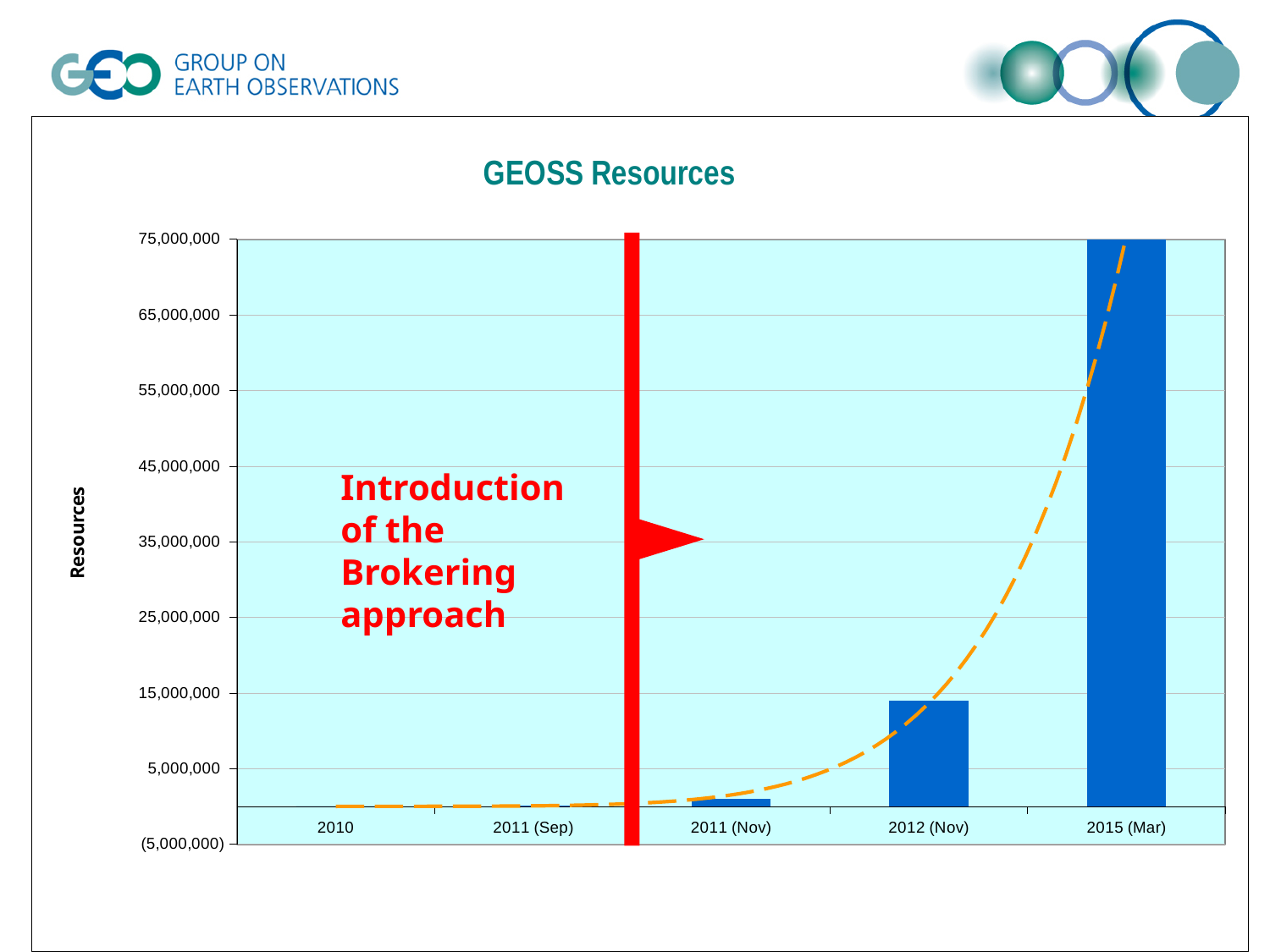
How many categories are shown on the x axis of the chart? 5 Which is larger, the value for 2011 (Nov) or the value for 2012 (Nov)? 2012 (Nov) Is the value for 2012 (Nov) greater or less than 5,000,000? greater What is the title of the chart? GEOSS Resources What kind of chart is shown on the slide? bar chart What is the label on the vertical axis of the chart? Resources Which category has the highest value in the chart? 2015 (Mar) Which is larger, the value for 2012 (Nov) or the value for 2015 (Mar)? 2015 (Mar) Is the value for 2011 (Nov) greater or less than 5,000,000? less Is the value for 2015 (Mar) greater or less than 65,000,000? greater Do the values rise or fall from left to right along the x axis? rise